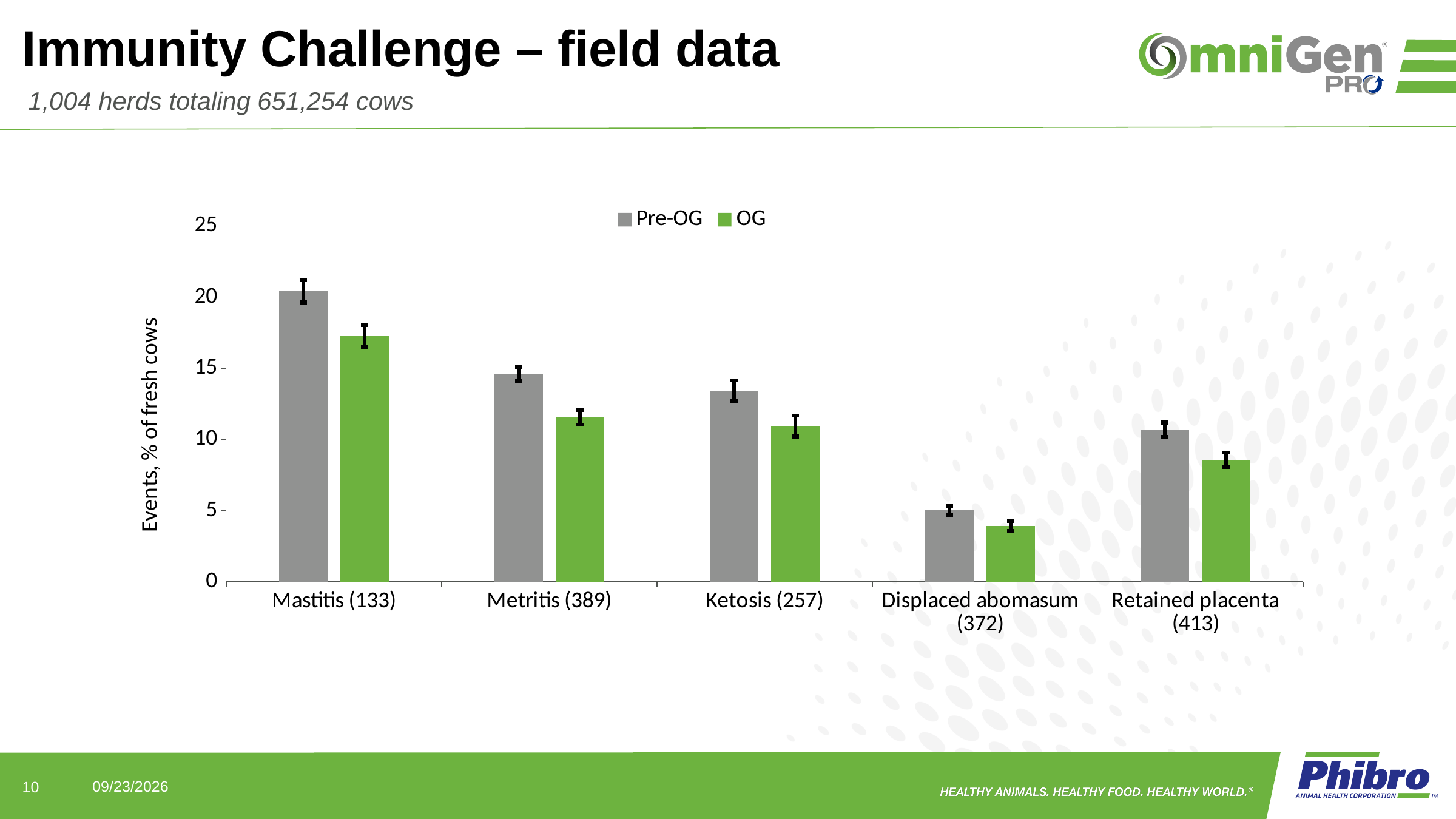
How many series does the legend list? 2 Which is larger: the OG value for Mastitis (133) or the Pre-OG value for Metritis (389)? OG value for Mastitis (133) Which is larger: the OG value for Ketosis (257) or the OG value for Retained placenta (413)? OG value for Ketosis (257) How many categories are shown on the x axis? 5 Is the OG value for Displaced abomasum (372) greater or less than 5? less Which category has the lowest OG value? Displaced abomasum (372) Is the OG value for Retained placenta (413) greater or less than 10? less Is the OG value for Mastitis (133) greater or less than 15? greater What is the title of the y axis? Events, % of fresh cows Which category has the highest Pre-OG value? Mastitis (133) What kind of chart is shown on the slide? bar chart